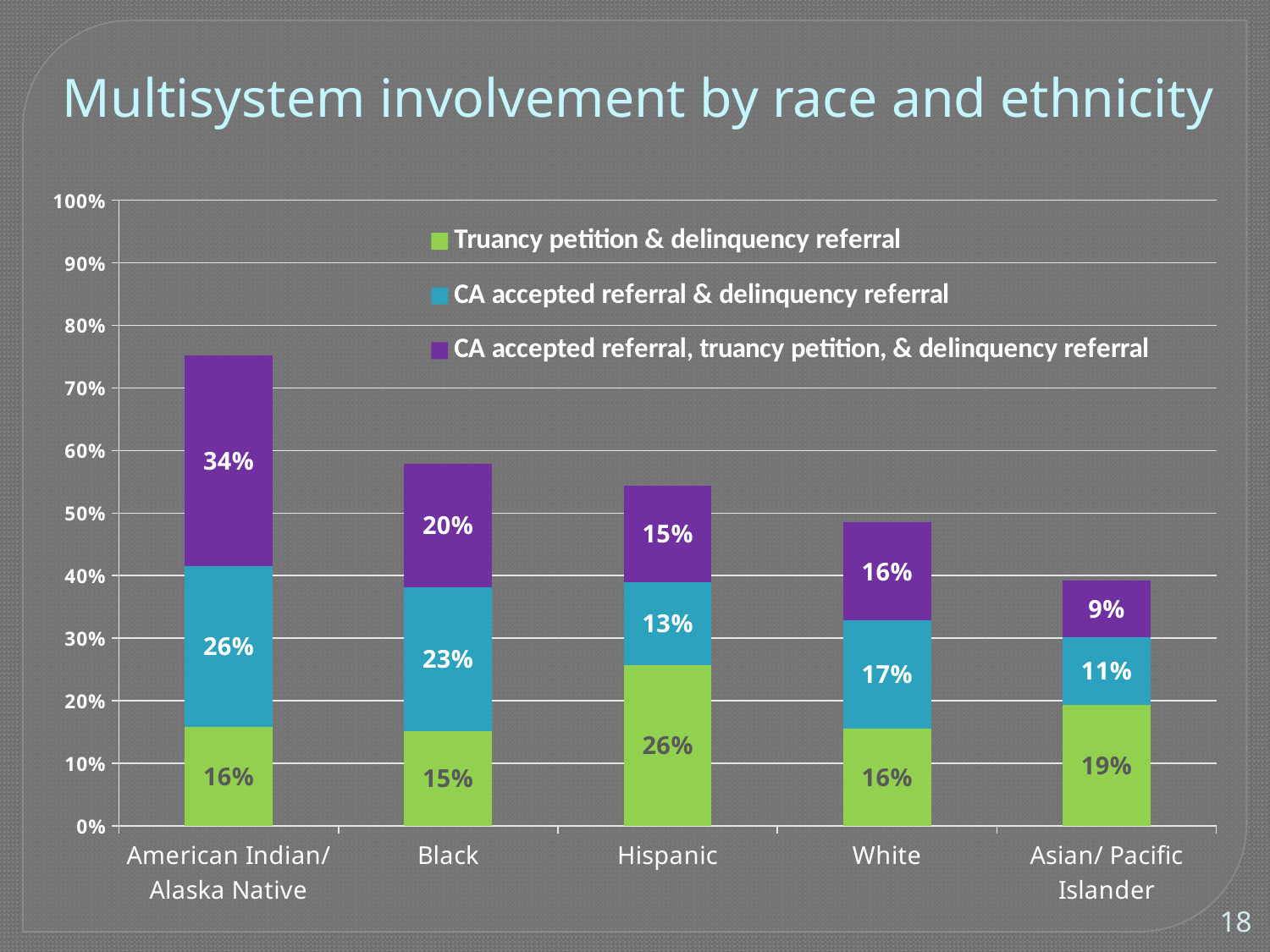
Which category has the lowest value for 'CA accepted referral & delinquency referral'? Asian/Pacific Islander How many series does the legend list? 3 What is the title of the chart? Multisystem involvement by race and ethnicity What kind of chart is shown on the slide? Stacked bar chart How many race/ethnicity categories are shown on the x axis? 5 Which category has the highest value for 'CA accepted referral, truancy petition, & delinquency referral'? American Indian/Alaska Native What is the value of 'Truancy petition & delinquency referral' for Hispanic? 26% What is the difference between the 'CA accepted referral & delinquency referral' values for American Indian/Alaska Native and White? 9% What is the total of the stacked bar for Black? 58% What is the value of 'CA accepted referral & delinquency referral' for Asian/Pacific Islander? 11% What is the value of 'CA accepted referral, truancy petition, & delinquency referral' for American Indian/Alaska Native? 34% Which is larger: the 'Truancy petition & delinquency referral' value for Hispanic or for Black? Hispanic